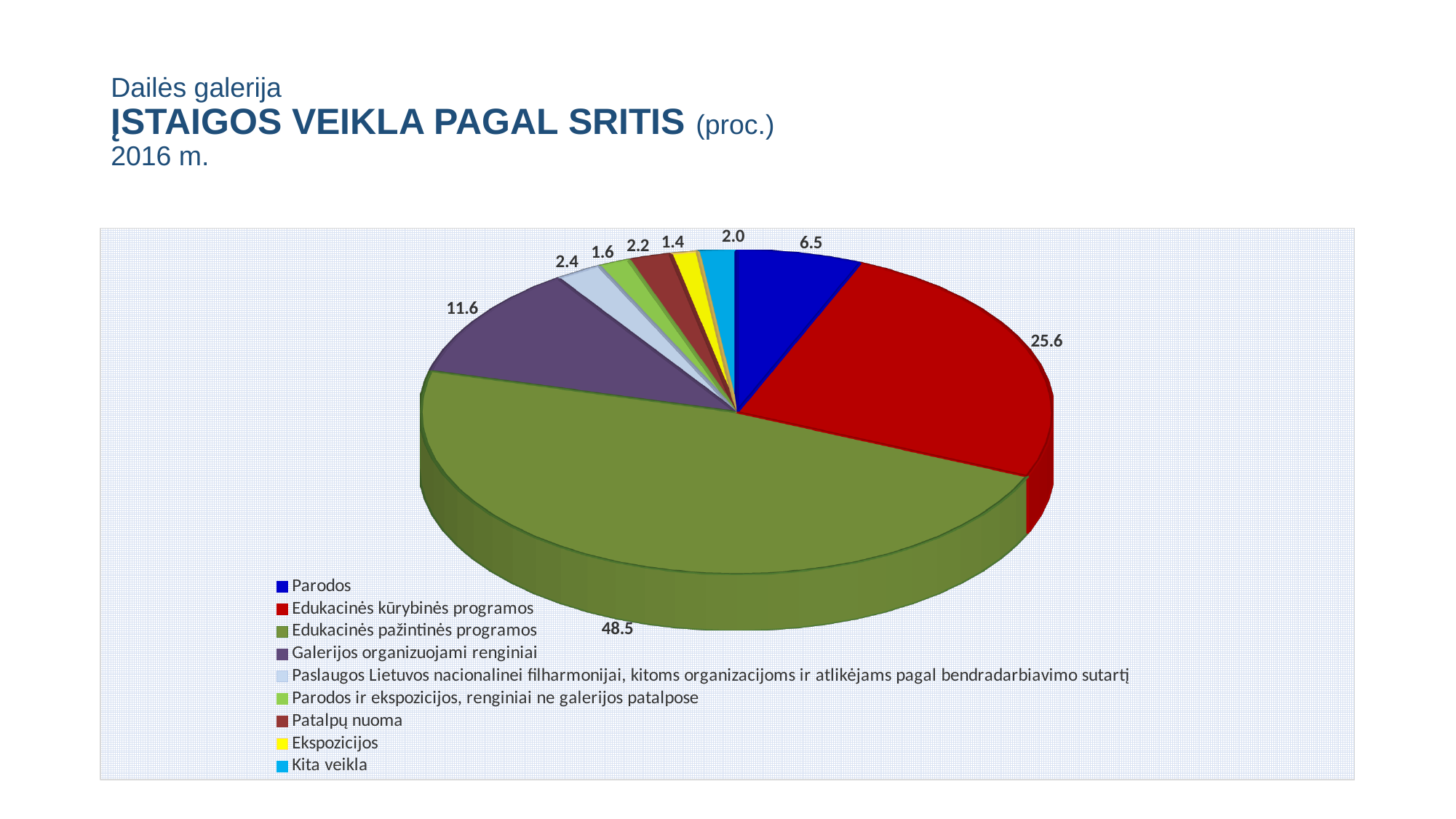
Which is larger, the value for Parodos or the value for Galerijos organizuojami renginiai? Galerijos organizuojami renginiai What is the value for Edukacinės kūrybinės programos? 25.6 What kind of chart is shown on the slide? pie chart What is the value for Edukacinės pažintinės programos? 48.5 What is the value for Parodos? 6.5 What is the value for Patalpų nuoma? 2.2 Which category has the smallest slice of the pie? Ekspozicijos How many categories does the legend list? 9 What is the difference between the values for Edukacinės pažintinės programos and Edukacinės kūrybinės programos? 22.9 Which category has the largest slice of the pie? Edukacinės pažintinės programos What is the value for Galerijos organizuojami renginiai? 11.6 What is the value for Kita veikla? 2.0